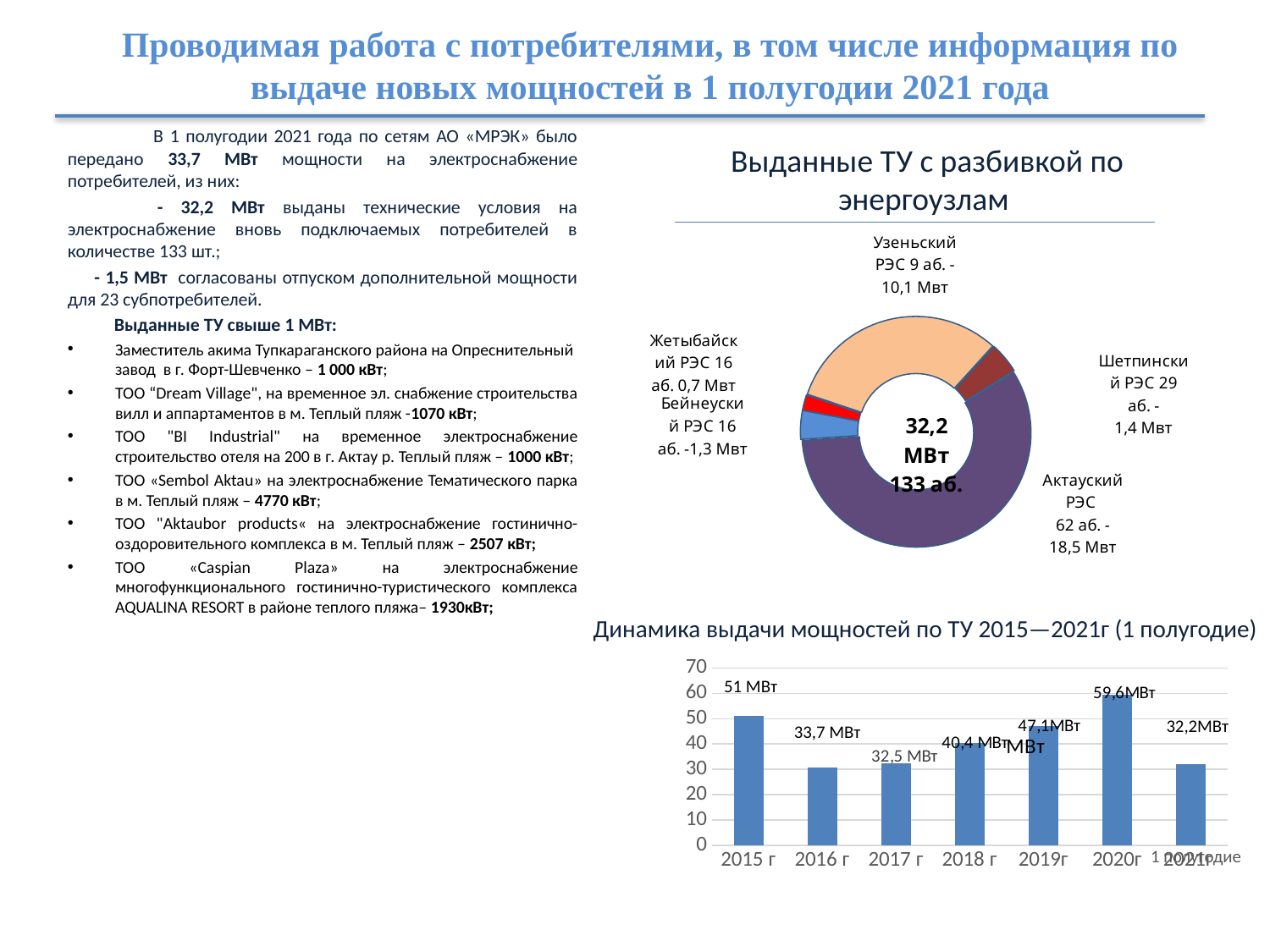
In the bar chart 'Динамика выдачи мощностей по ТУ 2015—2021г (1 полугодие)', what is the value for 2020г? 59,6МВт In the bar chart 'Динамика выдачи мощностей по ТУ 2015—2021г (1 полугодие)', which is larger, the value for 2018 г or 2017 г? 2018 г In the bar chart 'Динамика выдачи мощностей по ТУ 2015—2021г (1 полугодие)', what is the difference between the values for 2020г and 2019г? 12,5 МВт In the bar chart 'Динамика выдачи мощностей по ТУ 2015—2021г (1 полугодие)', what is the value for 2015 г? 51 МВт In the bar chart 'Динамика выдачи мощностей по ТУ 2015—2021г (1 полугодие)', do the values rise or fall from 2017 г to 2020г? rise In the doughnut chart 'Выданные ТУ с разбивкой по энергоузлам', how many subscribers (аб.) are shown for Шетпинский РЭС? 29 аб. In the bar chart 'Динамика выдачи мощностей по ТУ 2015—2021г (1 полугодие)', which year has the highest value? 2020г In the doughnut chart 'Выданные ТУ с разбивкой по энергоузлам', which energy node has the smallest capacity? Жетыбайский РЭС What kind of chart is 'Динамика выдачи мощностей по ТУ 2015—2021г (1 полугодие)'? bar chart In the bar chart 'Динамика выдачи мощностей по ТУ 2015—2021г (1 полугодие)', how many bars are plotted? 7 In the doughnut chart 'Выданные ТУ с разбивкой по энергоузлам', how many МВт were issued for Актауский РЭС? 18,5 Мвт